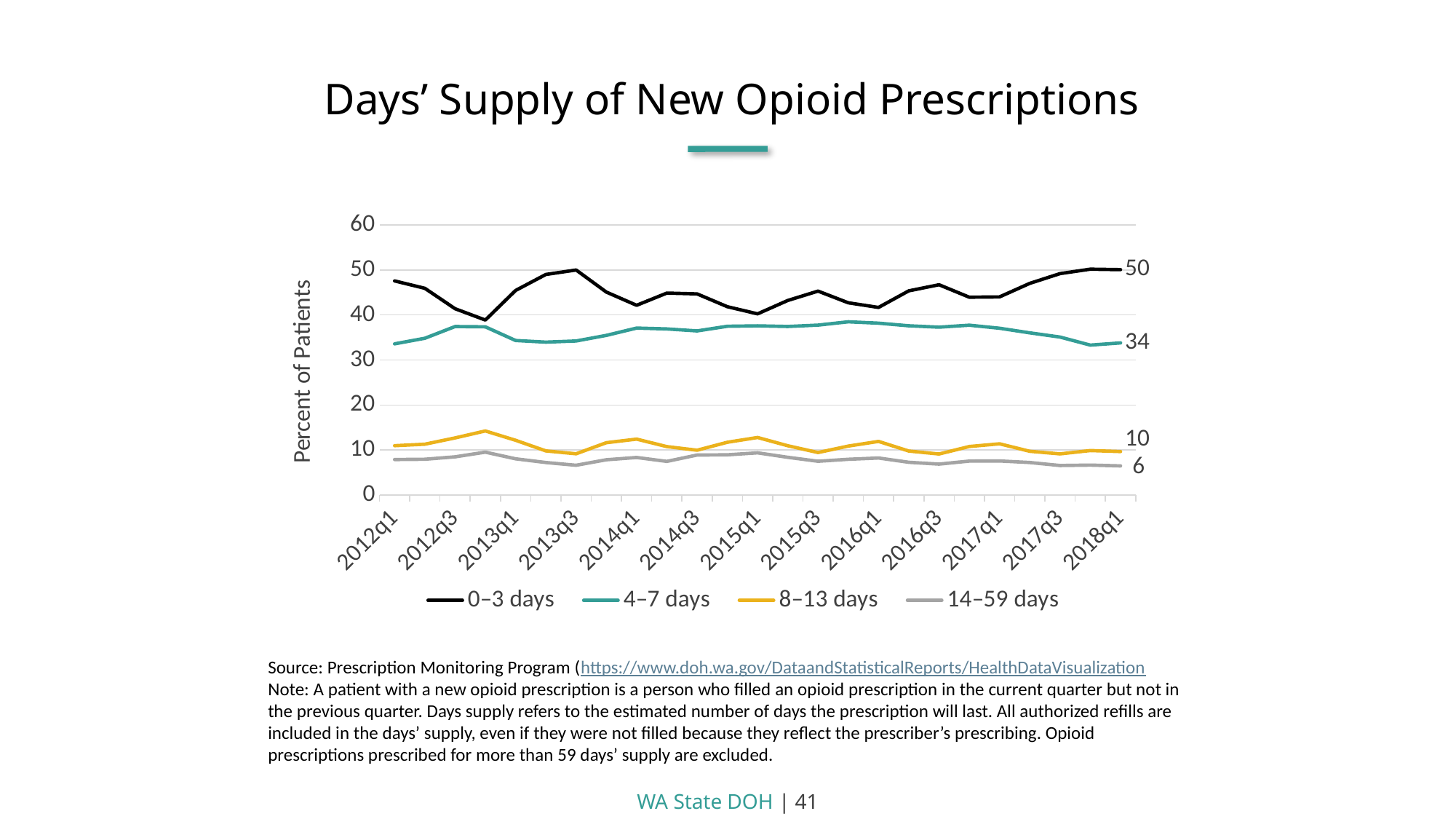
Which series has the highest value at 2018q1? 0–3 days Which series has the lowest value at 2018q1? 14–59 days What is the title of the y axis? Percent of Patients What kind of chart is shown on the slide? Line chart What is the value for the 8–13 days series at 2018q1? 10 Is the value for the 0–3 days series at 2013q3 greater or less than 40? greater What is the value for the 14–59 days series at 2018q1? 6 What is the total of the four series' labeled values at 2018q1? 100 How many series does the legend list? 4 What is the value for the 0–3 days series at 2018q1? 50 At 2018q1, how much higher is the 0–3 days value than the 4–7 days value? 16 What is the value for the 4–7 days series at 2018q1? 34